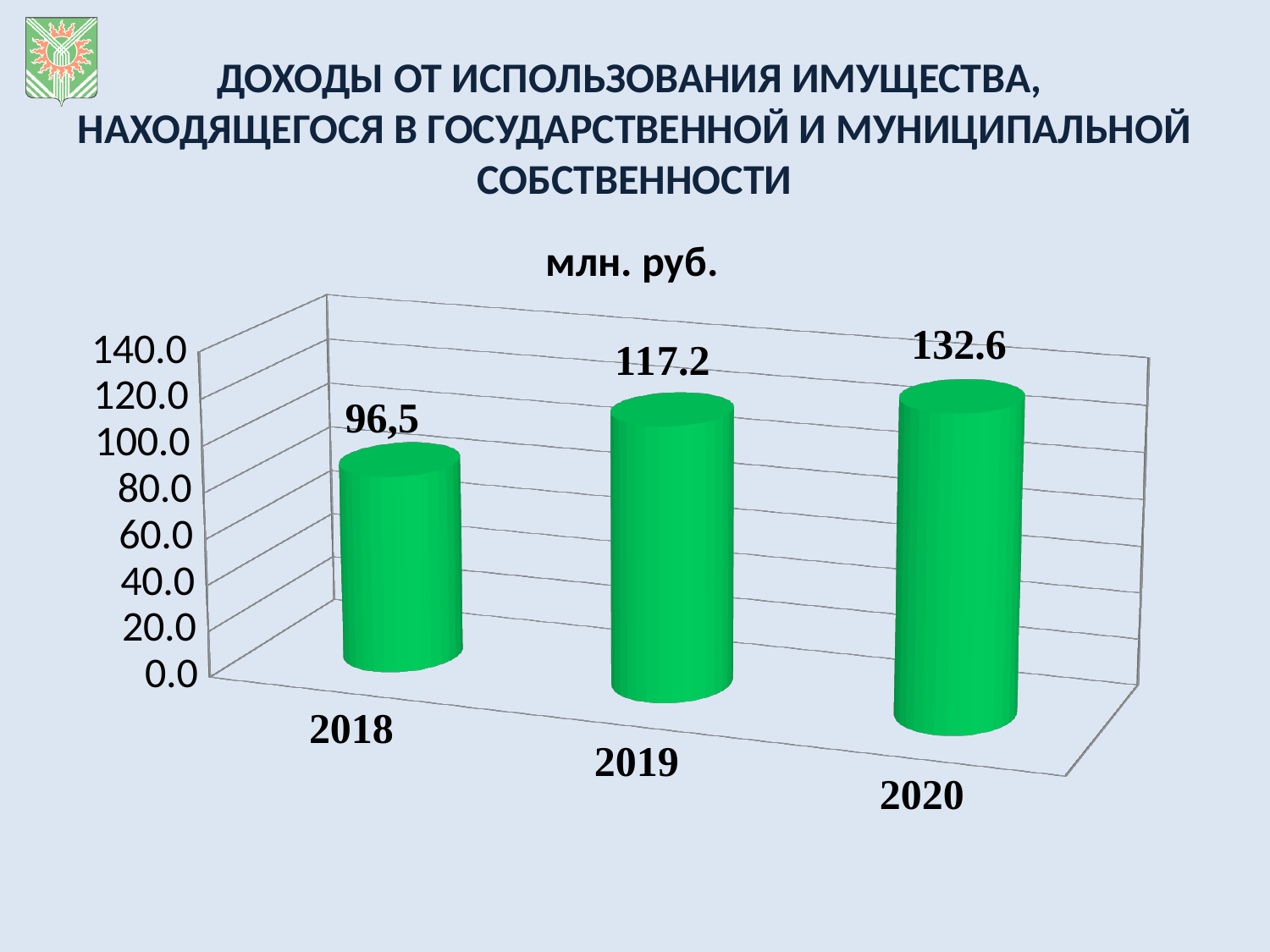
Is the value for 2020 greater or less than 120? greater Do the values rise or fall from 2018 to 2020? rise Is the value for 2018 greater or less than 100? less How many years are shown on the chart? 3 Which year has the lowest value? 2018 Which year has the highest value? 2020 Which is larger, the value for 2019 or the value for 2018? 2019 What is the value for 2019? 117.2 What is the value for 2018? 96,5 What kind of chart is shown on the slide? bar chart What is the difference between the values for 2020 and 2019? 15.4 What is the value for 2020? 132.6